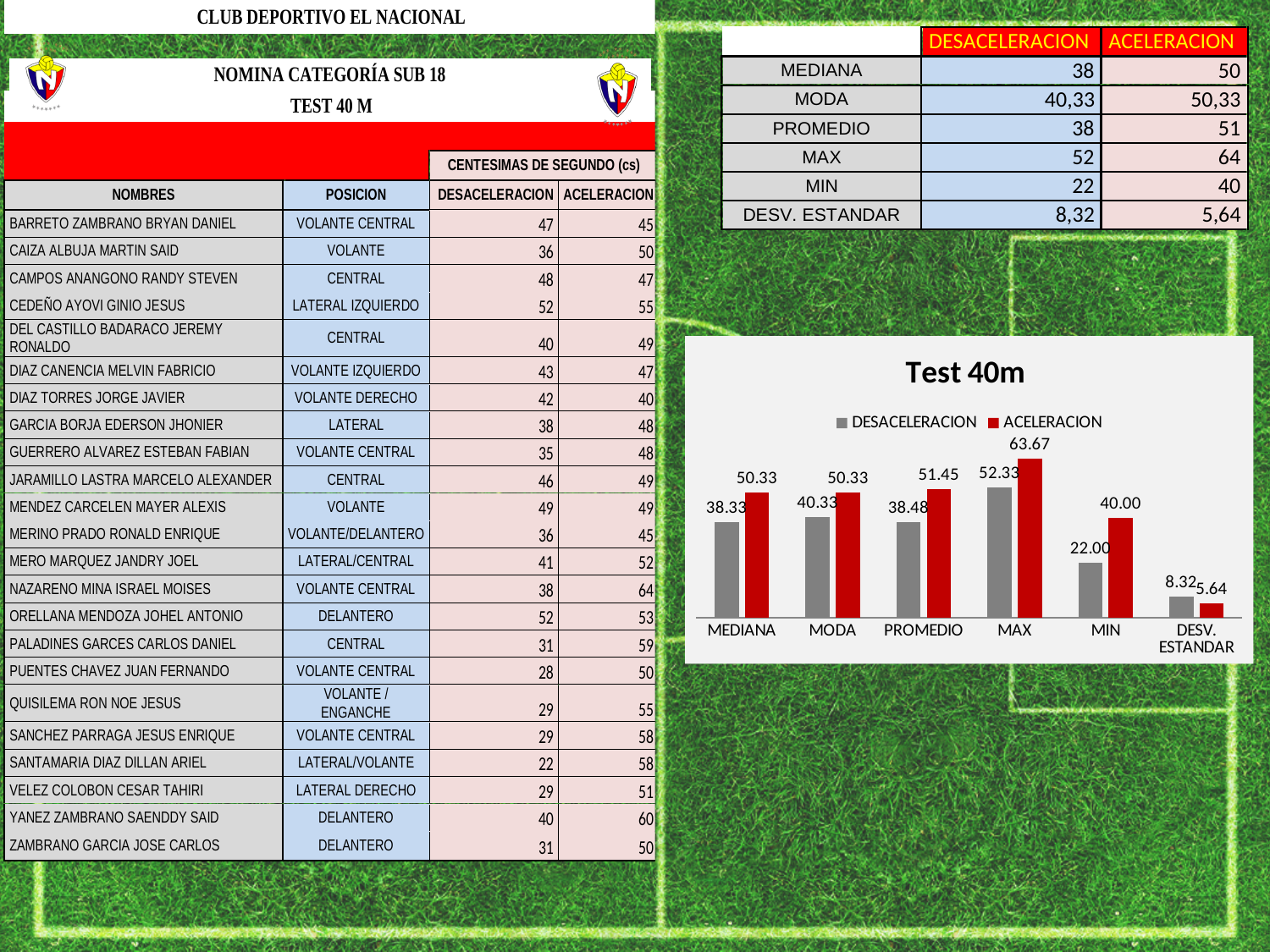
In the Test 40m chart, what is the ACELERACION value for MAX? 63.67 What type of chart is the Test 40m chart? Bar chart In the Test 40m chart, what is the difference between the ACELERACION and DESACELERACION values for MIN? 18.00 In the Test 40m chart, what is the DESACELERACION value for MIN? 22.00 In the Test 40m chart, what is the DESACELERACION value for PROMEDIO? 38.48 In the Test 40m chart, what is the ACELERACION value for DESV. ESTANDAR? 5.64 In the Test 40m chart, which category has the lowest DESACELERACION value? DESV. ESTANDAR How many series does the legend of the Test 40m chart list? 2 In the Test 40m chart, which category has the highest ACELERACION value? MAX In the Test 40m chart, which is larger for DESV. ESTANDAR: DESACELERACION or ACELERACION? DESACELERACION How many categories are shown on the x axis of the Test 40m chart? 6 In the Test 40m chart, which colour represents the ACELERACION series? Red